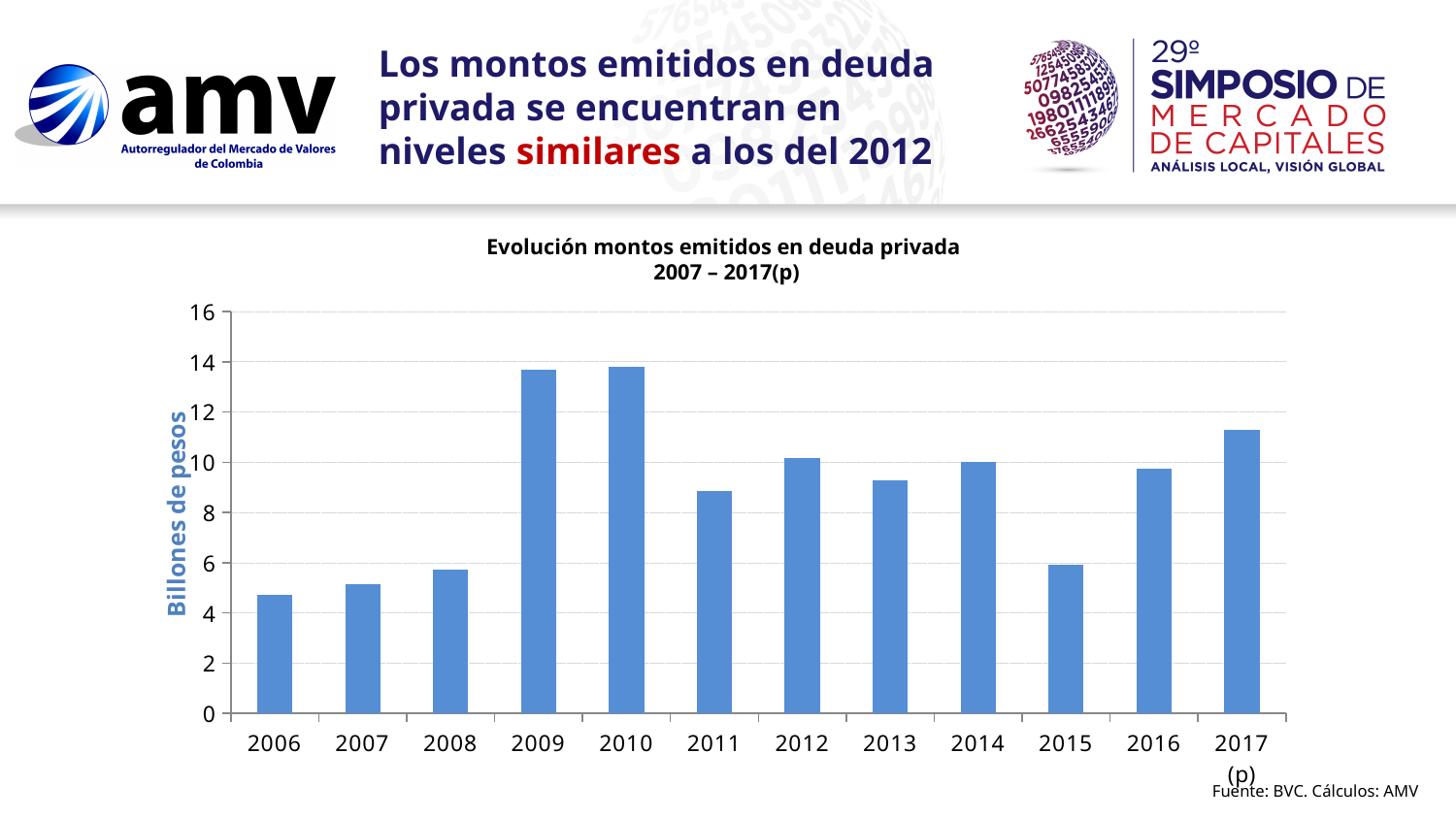
Is the value for 2006 greater or less than 6? less Which is larger, the value for 2017 or the value for 2012? 2017 What is the label on the y axis of the chart? Billones de pesos How many years are plotted on the x axis of the chart? 12 What kind of chart is shown on the slide? bar chart Do the values rise or fall from 2006 to 2010? rise Is the value for 2009 greater or less than 12? greater Is the value for 2013 greater or less than 10? less Which year has the lowest value in the chart? 2006 Which is larger, the value for 2015 or the value for 2016? 2016